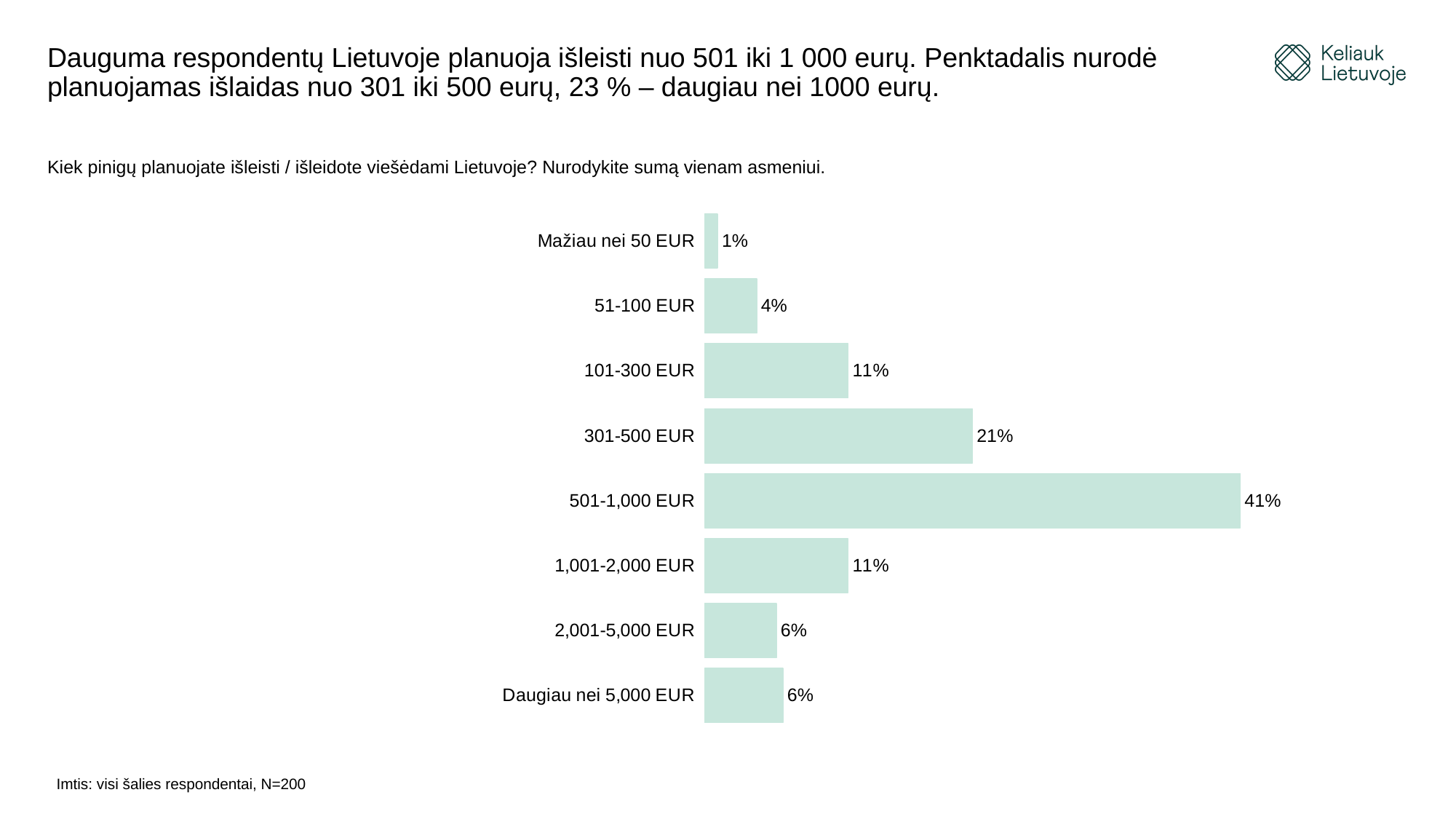
What kind of chart is shown on the slide? Bar chart What is the sample size stated at the bottom of the slide? N=200 How many categories are shown in the chart? 8 Which category has the highest value? 501-1,000 EUR Which is larger: the value for 1,001-2,000 EUR or the value for 2,001-5,000 EUR? 1,001-2,000 EUR What percentage is shown for 'Mažiau nei 50 EUR'? 1% What is the difference between the 101-300 EUR and 51-100 EUR values? 7% Which category has the lowest value? Mažiau nei 50 EUR What is the difference between the 501-1,000 EUR and 301-500 EUR values? 20% What is the value for the 301-500 EUR category? 21% What is the value for 2,001-5,000 EUR? 6% What percentage of respondents plan to spend 501-1,000 EUR? 41%